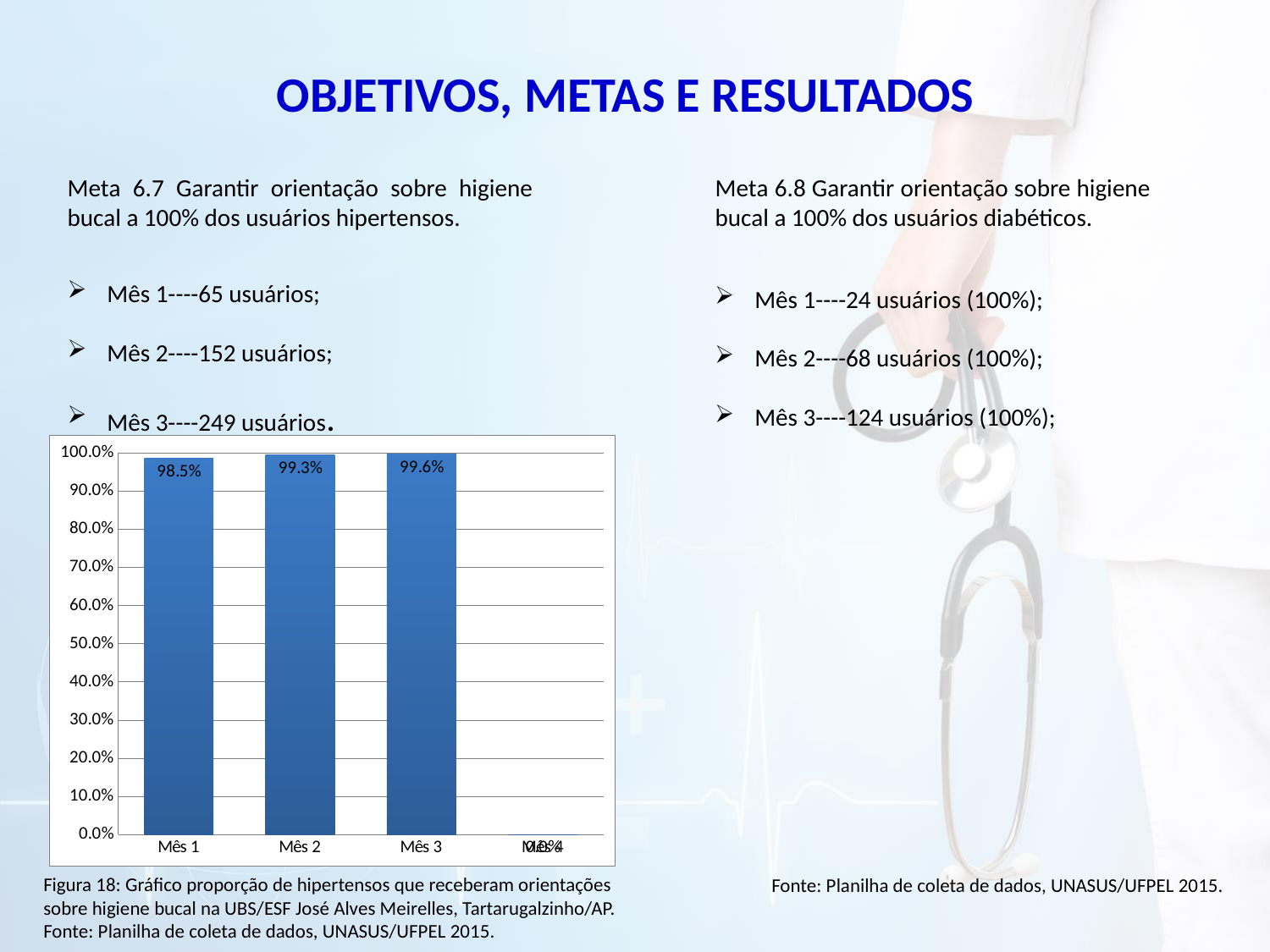
Do the values rise or fall from Mês 1 to Mês 3? Rise What is the value shown for Mês 1 in the chart? 98.5% What is the difference between the values for Mês 2 and Mês 1? 0.8 percentage points What kind of chart is shown on the slide? Bar chart Is the value for Mês 1 greater or less than 90.0%? greater Which is larger, the value for Mês 2 or the value for Mês 3? Mês 3 How many month categories are shown on the x axis of the chart? 4 Among Mês 1, Mês 2 and Mês 3, which has the lowest value? Mês 1 What is the value shown for Mês 3 in the chart? 99.6% What is the value shown for Mês 2 in the chart? 99.3% Which month has the highest value in the chart? Mês 3 What is the difference between the values for Mês 3 and Mês 1? 1.1 percentage points